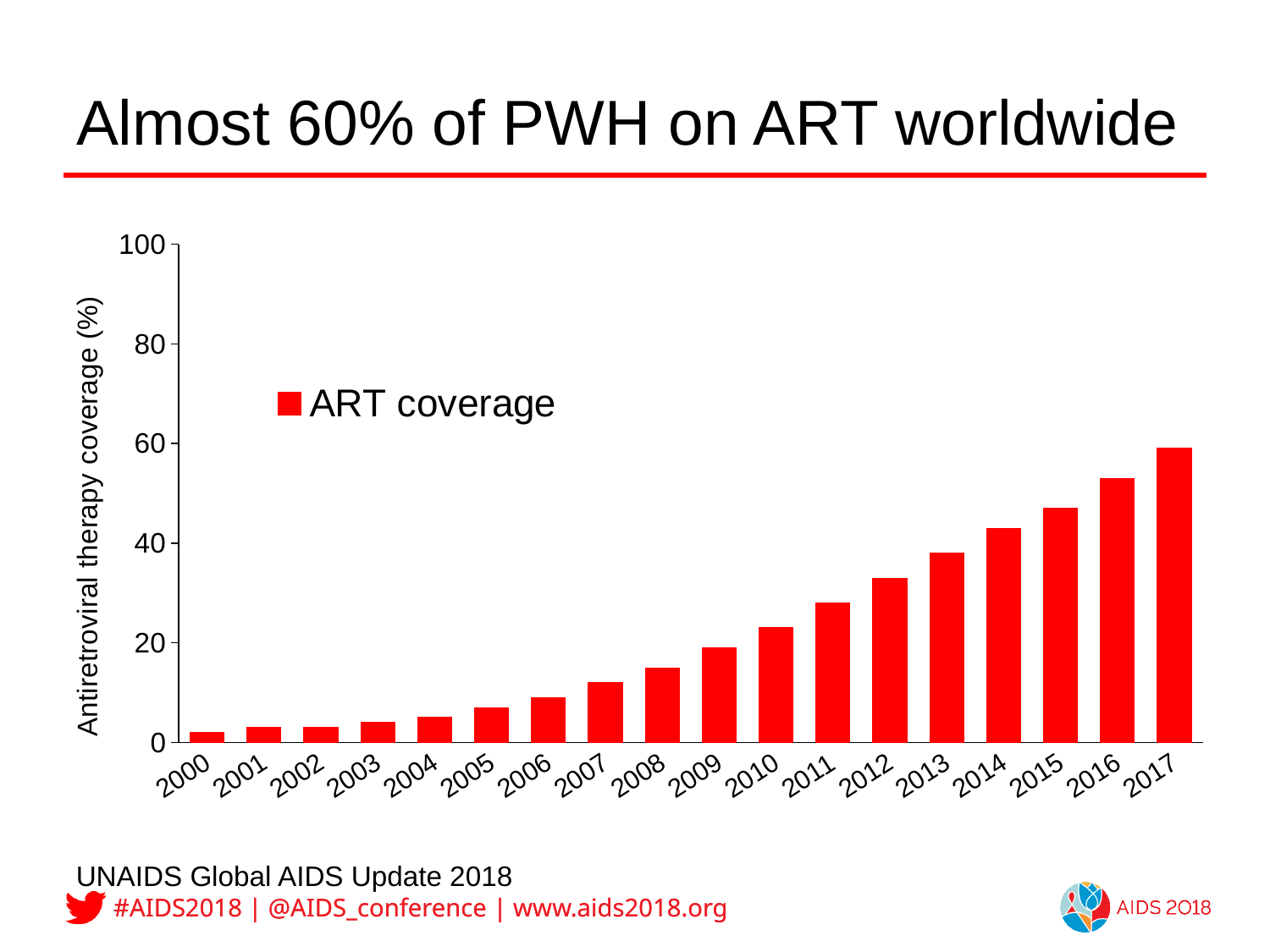
How many years are shown on the x axis? 18 Is the value for 2012 greater or less than 40? less Do the ART coverage values rise or fall from 2000 to 2017? rise What kind of chart is shown on the slide? bar chart Is the value for 2016 greater or less than 40? greater What is the label of the y axis? Antiretroviral therapy coverage (%) Is the value for 2008 greater or less than 20? less Which year has the highest ART coverage? 2017 Which year has the larger ART coverage, 2015 or 2010? 2015 How many series does the legend list? 1 Which year has the lowest ART coverage? 2000